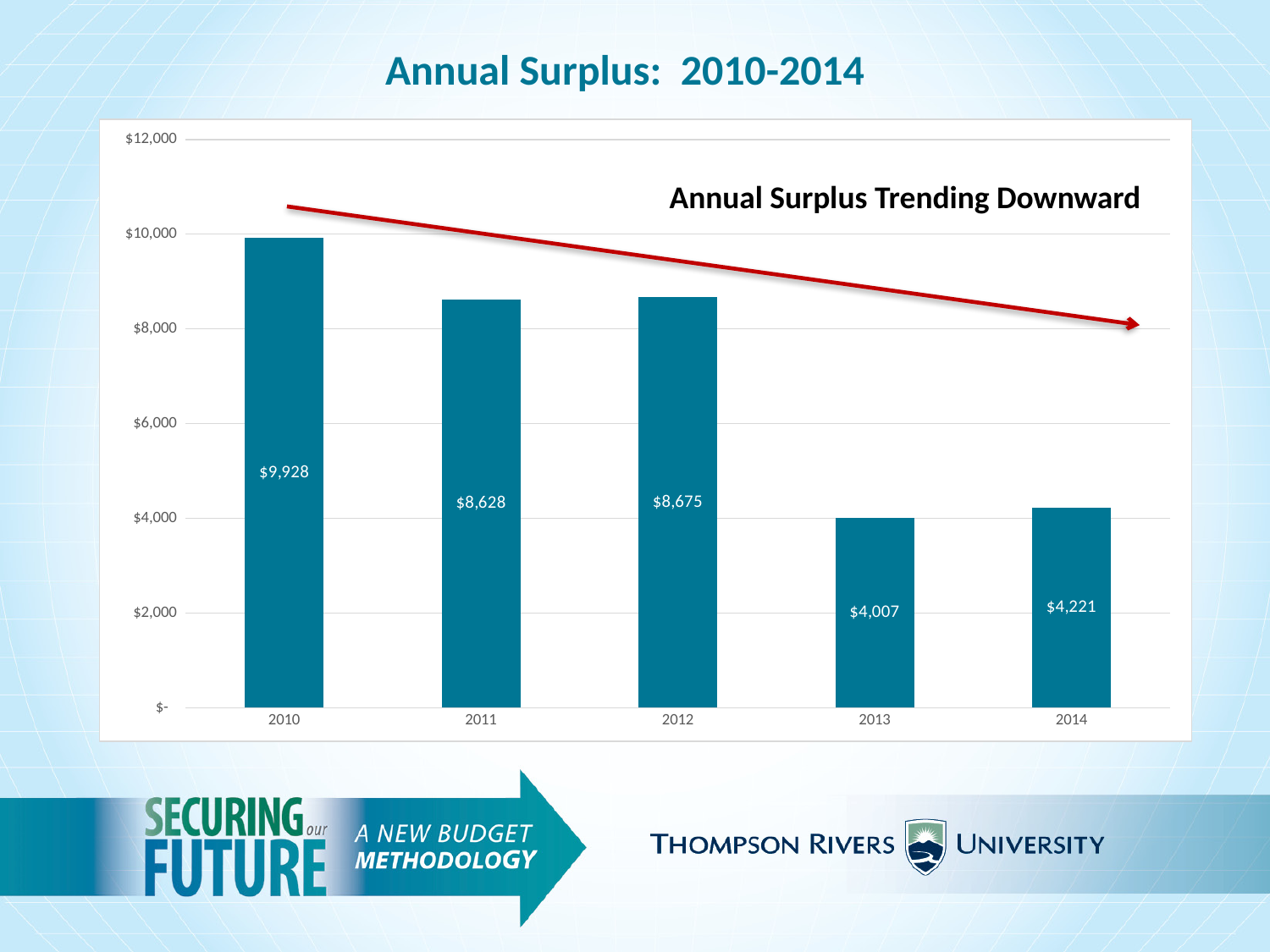
How many years are shown on the chart? 5 What is the annual surplus for 2010? $9,928 Which year has the lowest annual surplus? 2013 What kind of chart is shown on the slide? Bar chart What is the annual surplus for 2013? $4,007 What is the annual surplus for 2014? $4,221 What is the difference between the annual surplus in 2010 and 2014? $5,707 Is the annual surplus for 2012 greater or less than $8,000? greater Which year has the highest annual surplus? 2010 What is the difference between the annual surplus in 2012 and 2011? $47 Which year has a larger annual surplus, 2011 or 2013? 2011 What is the overall trend of the annual surplus from 2010 to 2014? Downward